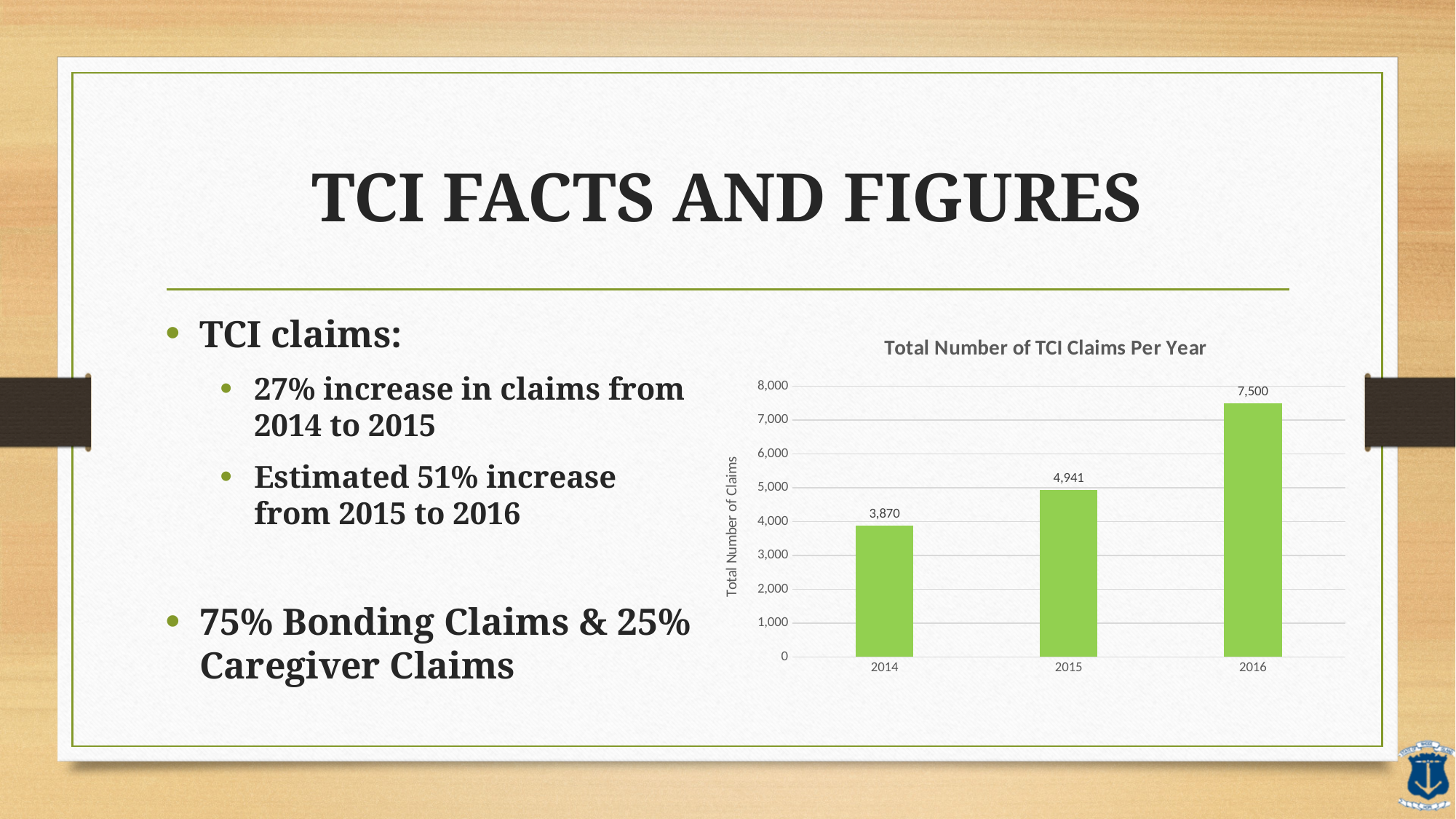
How many years are shown in the chart? 3 What is the total number of TCI claims shown for 2015? 4,941 Which year has the lowest number of TCI claims in the chart? 2014 Do the TCI claims rise or fall from 2014 to 2016? Rise What is the difference in TCI claims between 2016 and 2015? 2,559 Which year has the highest number of TCI claims in the chart? 2016 What is the total number of TCI claims shown for 2014? 3,870 What is the total number of TCI claims shown for 2016? 7,500 Which year had more TCI claims, 2014 or 2015? 2015 Is the value for 2016 greater or less than 7,000? greater What is the difference in TCI claims between 2015 and 2014? 1,071 What kind of chart is shown on the slide? Bar chart